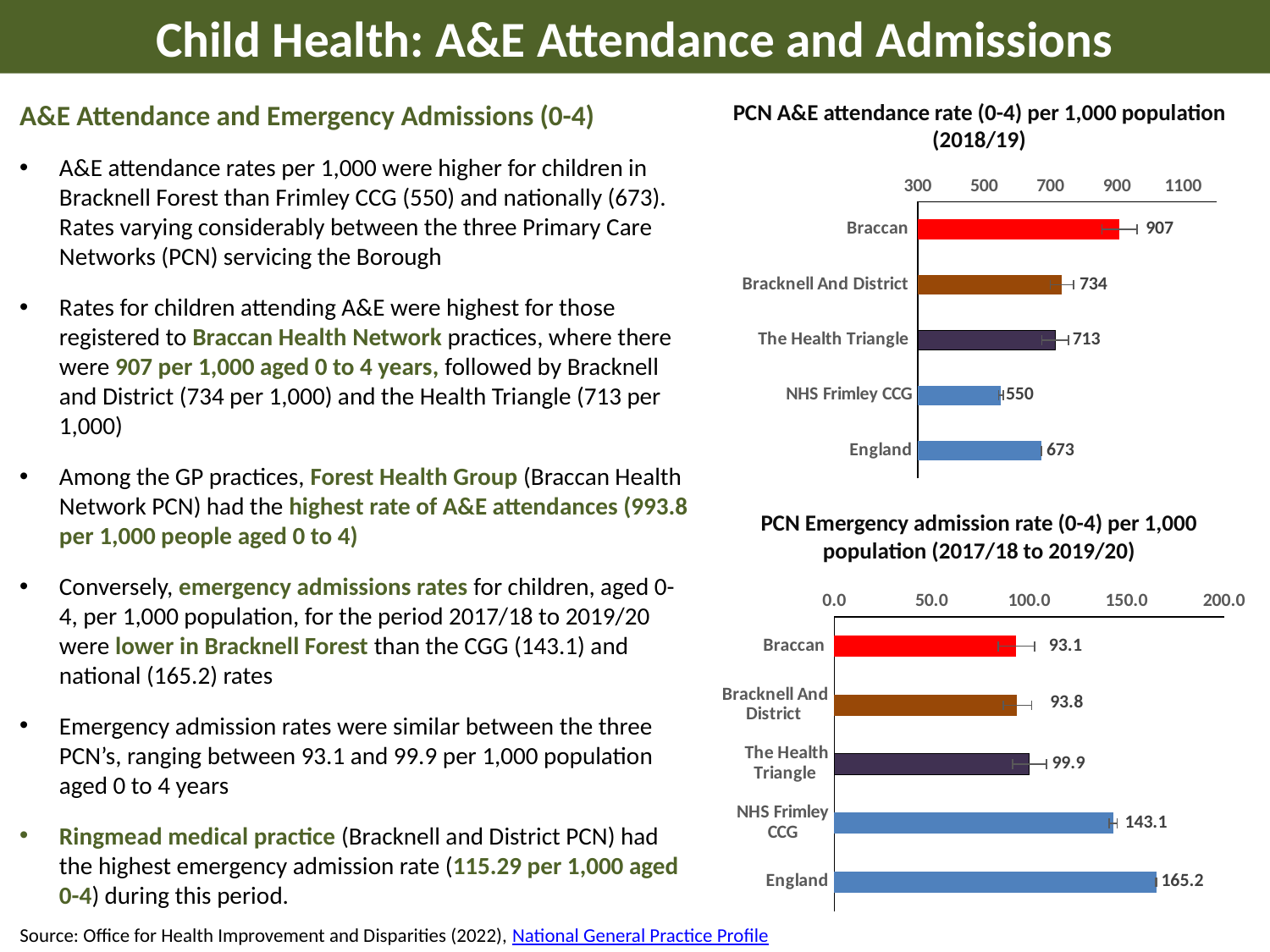
In the 'PCN Emergency admission rate (0-4) per 1,000 population (2017/18 to 2019/20)' chart, which category has the highest value? England In the 'PCN A&E attendance rate (0-4) per 1,000 population (2018/19)' chart, which category has the highest value? Braccan What type of chart is the 'PCN Emergency admission rate (0-4) per 1,000 population (2017/18 to 2019/20)' chart? Bar chart In the 'PCN A&E attendance rate (0-4) per 1,000 population (2018/19)' chart, how many categories are shown? 5 In the 'PCN Emergency admission rate (0-4) per 1,000 population (2017/18 to 2019/20)' chart, is the value for NHS Frimley CCG larger or smaller than the value for Braccan? larger In the 'PCN Emergency admission rate (0-4) per 1,000 population (2017/18 to 2019/20)' chart, what is the value for The Health Triangle? 99.9 In the 'PCN A&E attendance rate (0-4) per 1,000 population (2018/19)' chart, what is the difference between the values for Braccan and England? 234 In the 'PCN A&E attendance rate (0-4) per 1,000 population (2018/19)' chart, what is the value for Braccan? 907 In the 'PCN Emergency admission rate (0-4) per 1,000 population (2017/18 to 2019/20)' chart, what is the value for England? 165.2 In the 'PCN A&E attendance rate (0-4) per 1,000 population (2018/19)' chart, what is the value for NHS Frimley CCG? 550 In the 'PCN A&E attendance rate (0-4) per 1,000 population (2018/19)' chart, which category has the lowest value? NHS Frimley CCG In the 'PCN Emergency admission rate (0-4) per 1,000 population (2017/18 to 2019/20)' chart, what is the difference between the values for England and NHS Frimley CCG? 22.1